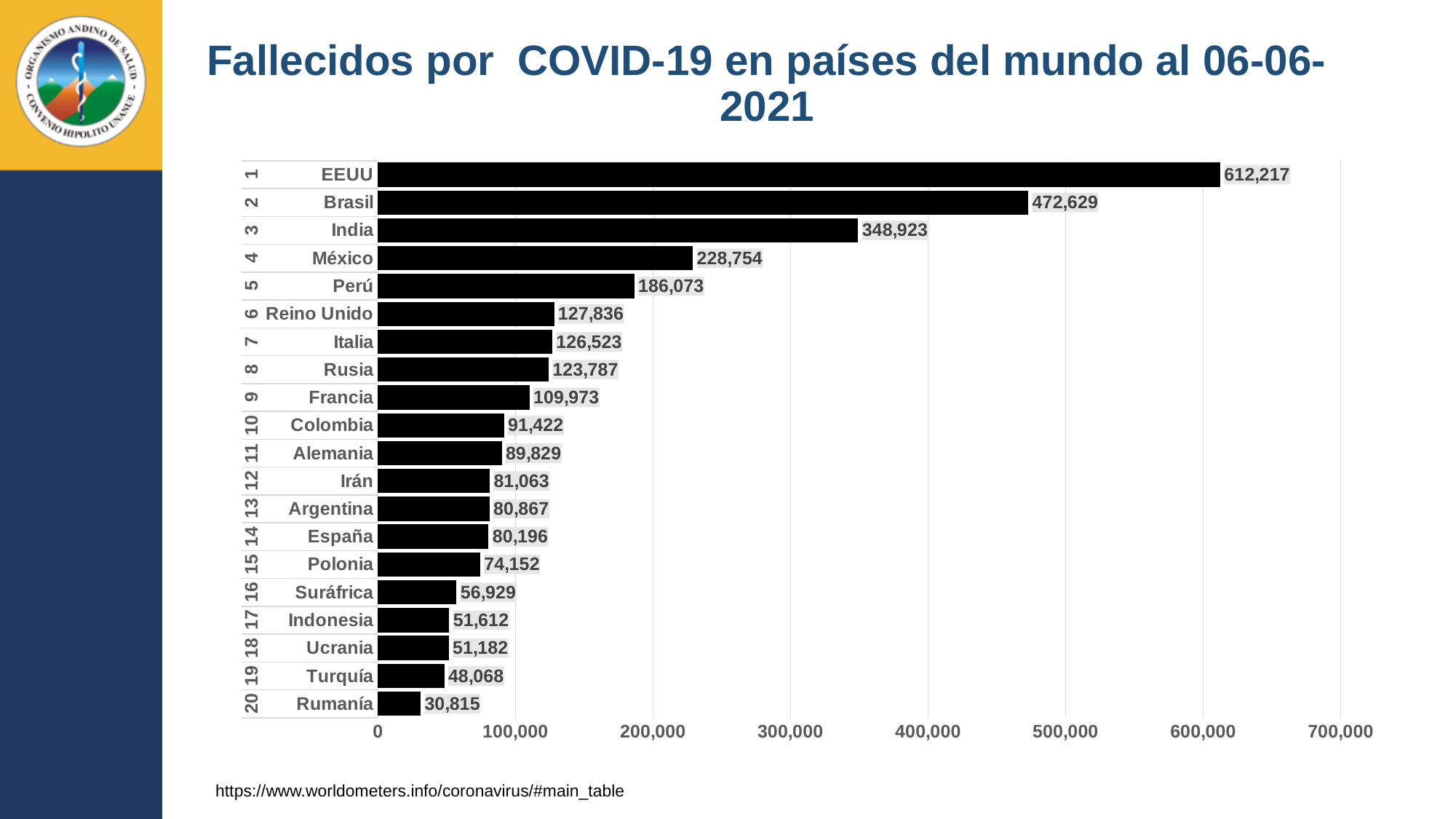
What is the title of the chart? Fallecidos por COVID-19 en países del mundo al 06-06-2021 What kind of chart is shown on the slide? bar chart How many countries are shown in the chart? 20 What is the value for Perú? 186,073 Which is larger, the value for Colombia or the value for Polonia? Colombia What is the difference between the values for México and Perú? 42,681 Is the value for India greater or less than 300,000? greater What is the value for Alemania? 89,829 Which country has the lowest value? Rumanía What is the value for Rumanía? 30,815 Which country has the highest value? EEUU What is the difference between the values for EEUU and Brasil? 139,588